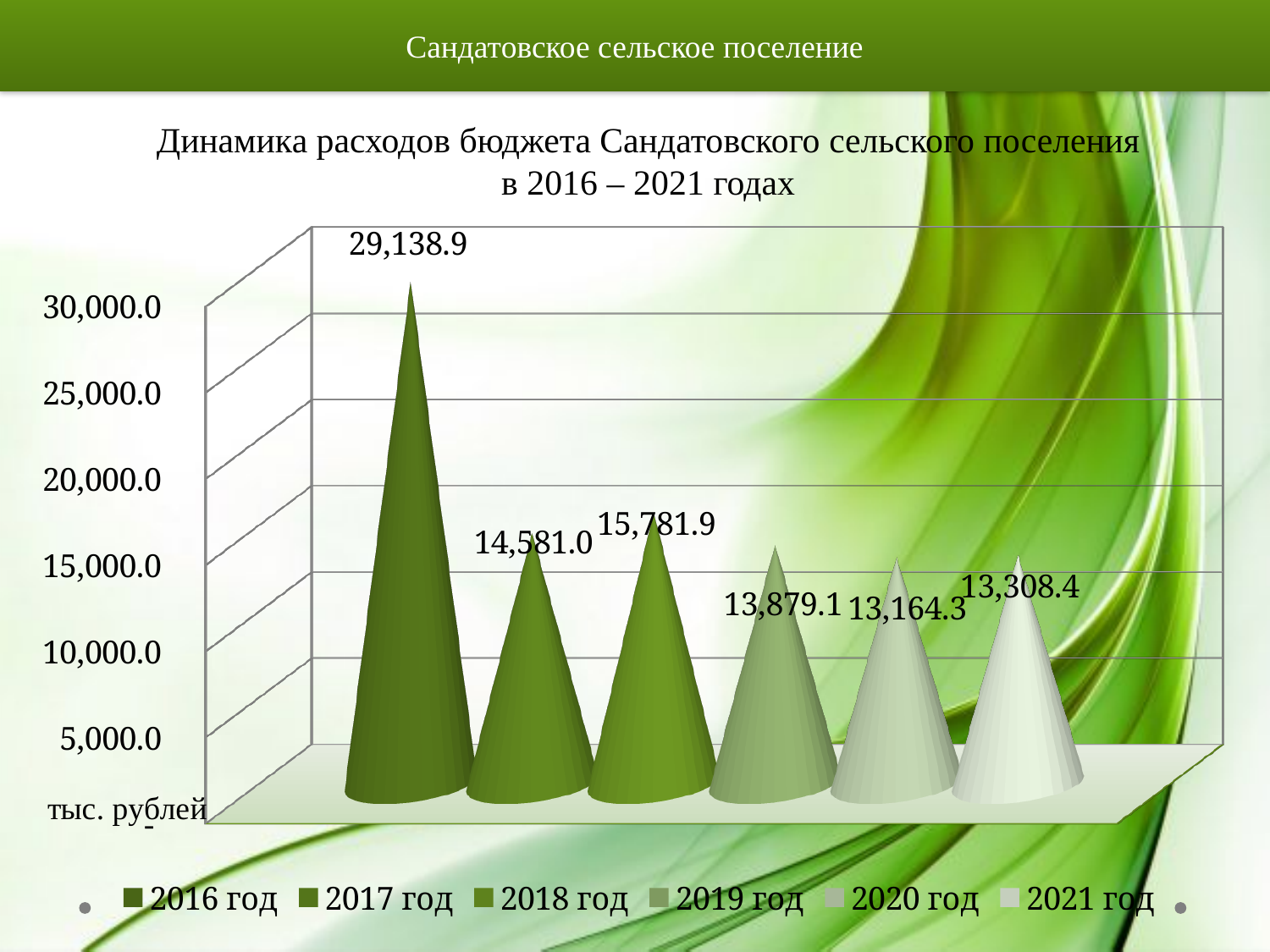
Which year has the highest expenditure value? 2016 год Which is larger, the value for 2017 год or the value for 2018 год? 2018 год How many entries does the legend list? 6 What value is shown for 2021 год? 13,308.4 What is the difference between the values for 2018 год and 2017 год? 1,200.9 Which year has the lowest expenditure value? 2020 год What unit of measurement is indicated on the chart? тыс. рублей Is the value for 2016 год greater or less than 25,000.0? greater What is the budget expenditure value shown for 2016 год? 29,138.9 What is the difference between the values for 2016 год and 2017 год? 14,557.9 What value is labelled for 2019 год? 13,879.1 How many years are plotted in the chart? 6